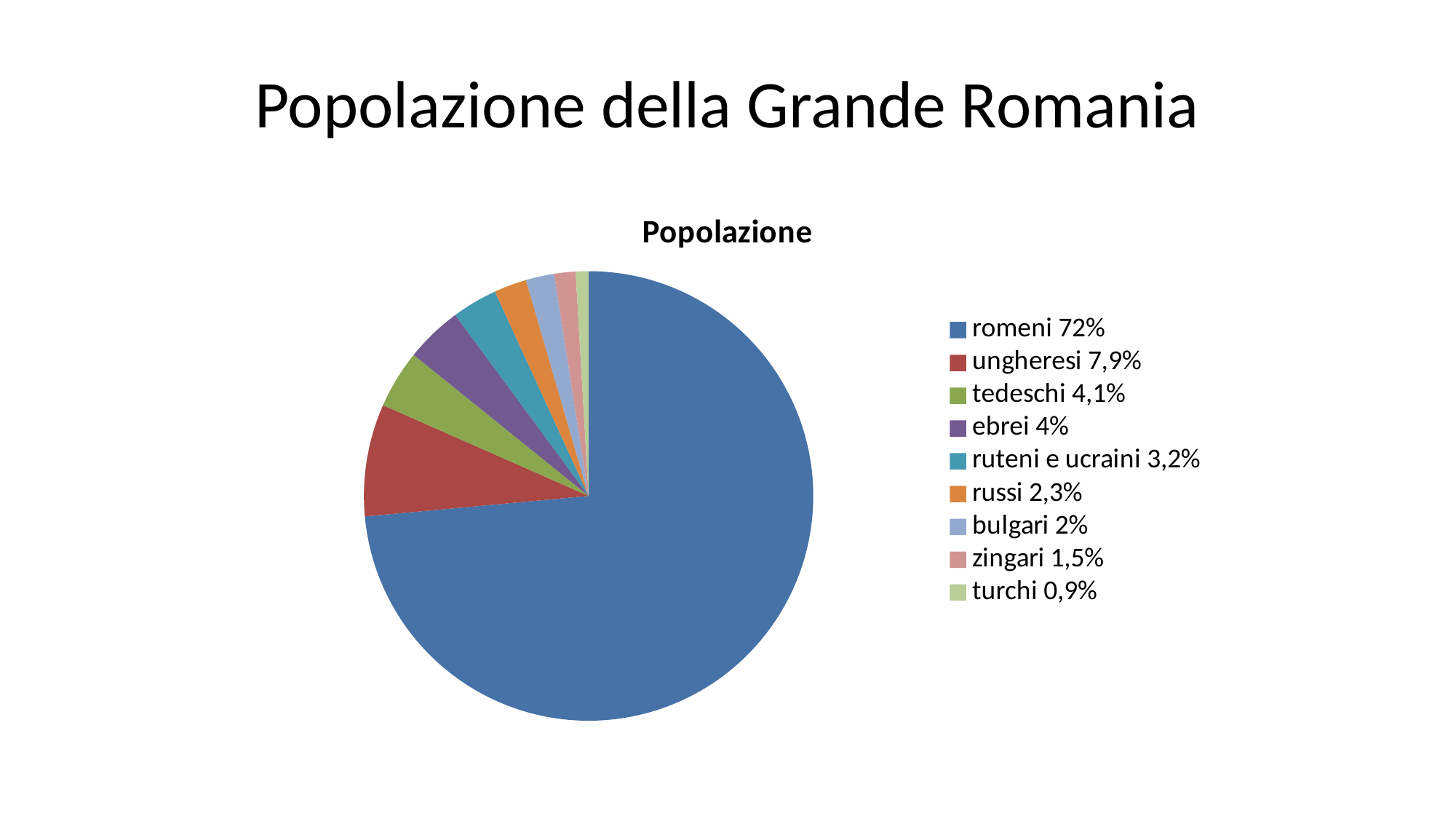
Which is larger, the share for tedeschi or the share for russi? tedeschi What is the chart's title? Popolazione What colour is the slice for bulgari? light blue What is the difference between the share for ungheresi and the share for ebrei? 3,9% What share of the population is ruteni e ucraini? 3,2% Which category has the largest share of the pie? romeni Which category has the smallest share of the pie? turchi How many categories does the pie chart have? 9 What kind of chart is shown on the slide? pie chart What share of the population is ungheresi? 7,9% What share of the population is turchi? 0,9%